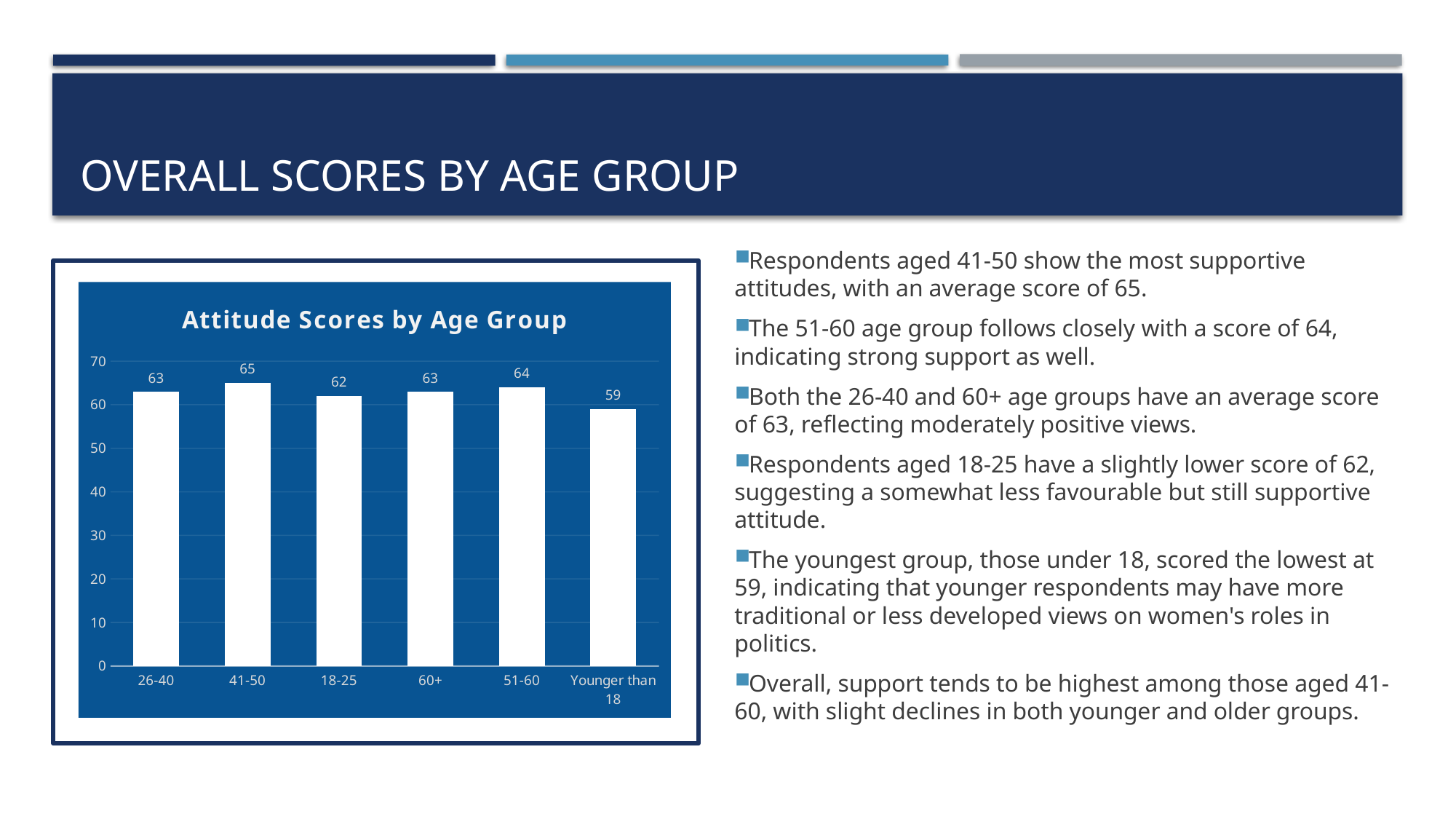
What is the attitude score for the 18-25 age group? 62 What type of chart is shown on the slide? Bar chart Which age group has the highest attitude score? 41-50 Is the value for the 60+ age group greater or less than 50? greater Which age group has the lowest attitude score? Younger than 18 What is the difference between the scores for the 41-50 and Younger than 18 groups? 6 What is the attitude score for the Younger than 18 group? 59 What is the difference between the scores for the 26-40 and 18-25 groups? 1 How many age groups are shown in the chart? 6 What is the attitude score for the 41-50 age group? 65 What is the title of the chart? Attitude Scores by Age Group Which has a higher attitude score, the 51-60 group or the 18-25 group? 51-60